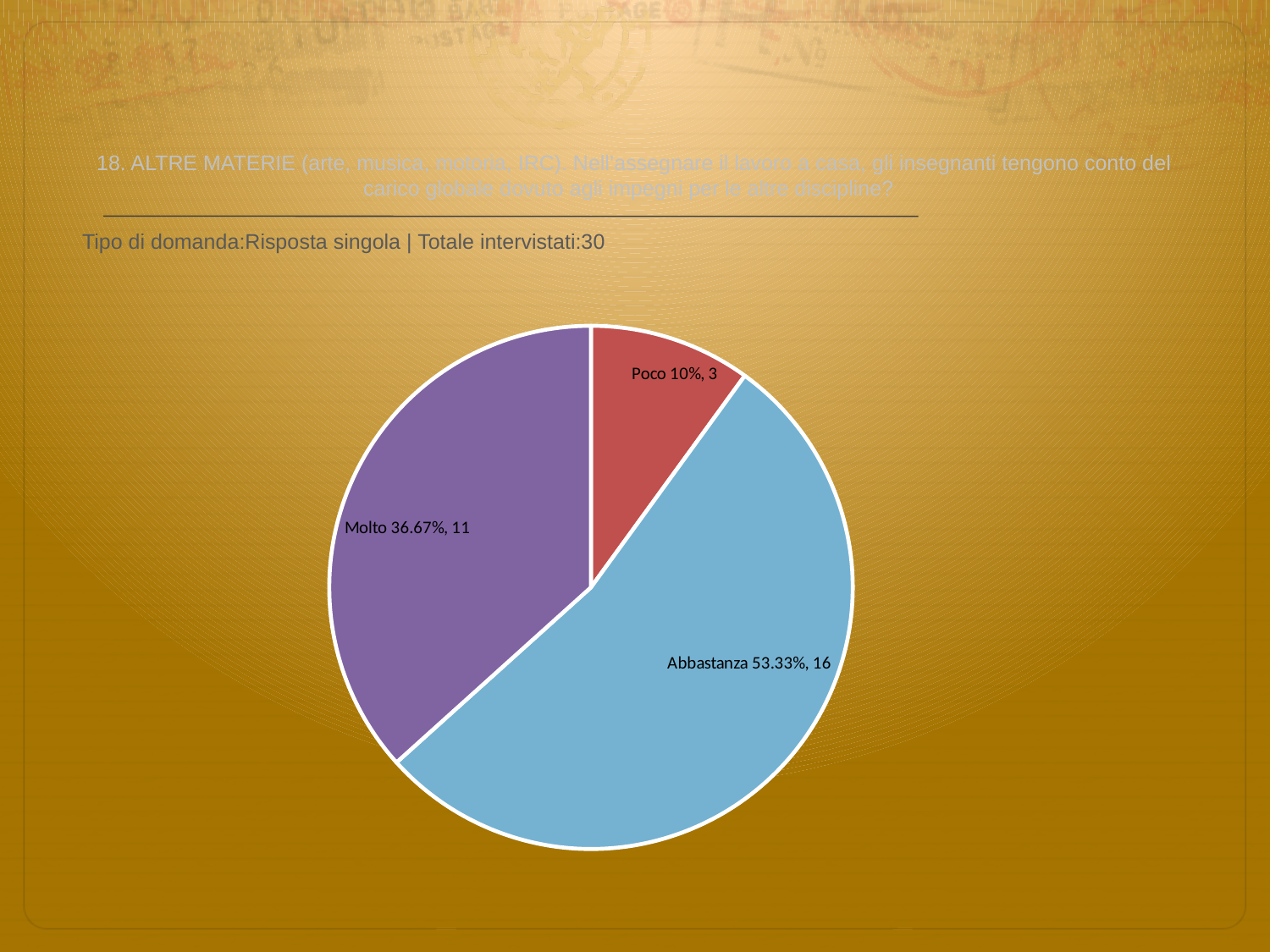
Which category has the largest slice? Abbastanza What percentage share does the Abbastanza slice have? 53.33% How many respondents answered Molto? 11 What percentage share does the Molto slice have? 36.67% What is the difference in respondent count between Abbastanza and Molto? 5 What percentage share does the Poco slice have? 10% Which category has the smallest slice? Poco How many slices does the pie chart have? 3 What kind of chart is shown on the slide? pie chart How many respondents answered Poco? 3 How many respondents answered Abbastanza? 16 Which colour is used for the Poco slice? red